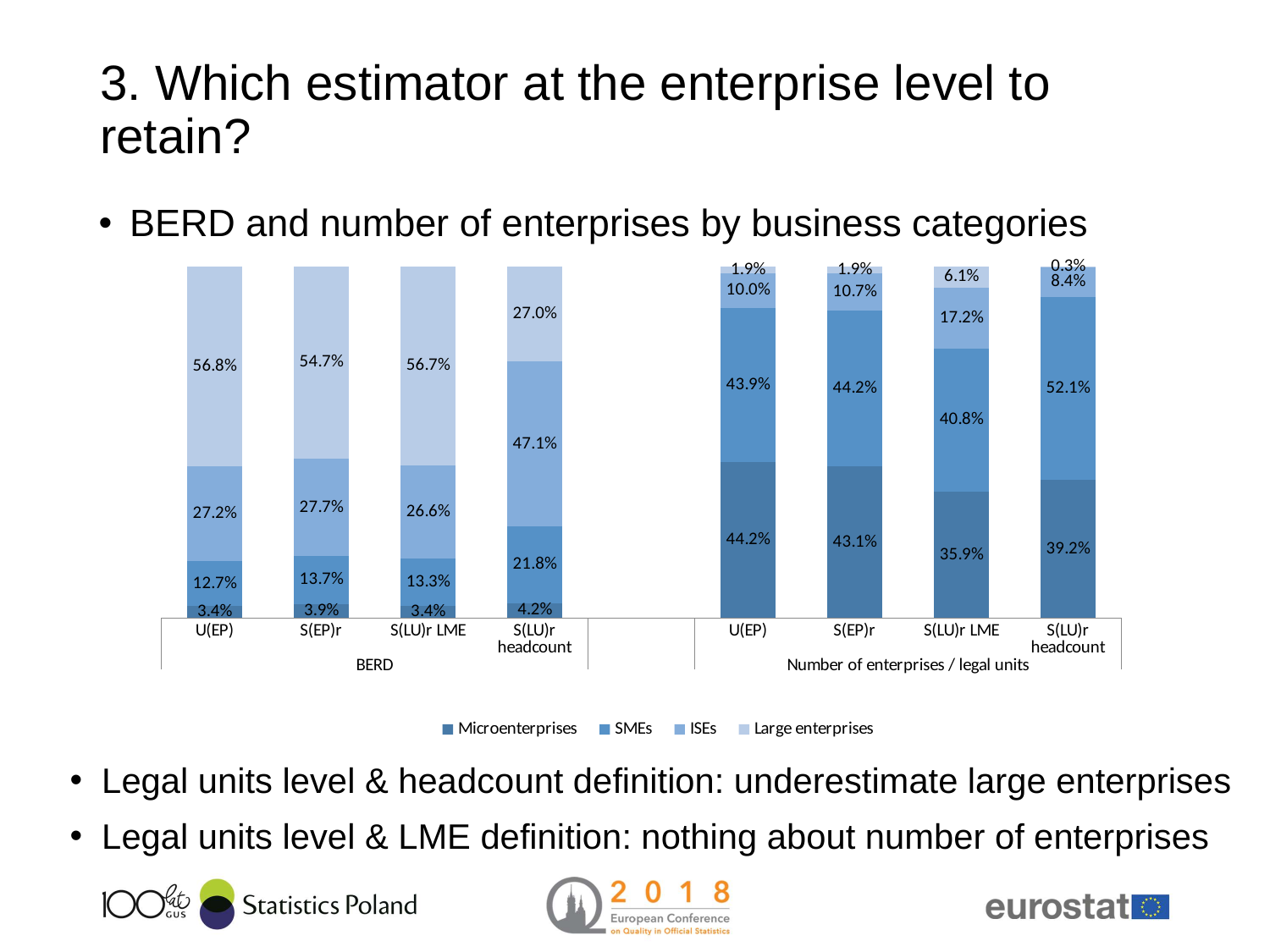
In the BERD group, which category has the highest Microenterprises share? S(LU)r headcount In the Number of enterprises / legal units group, which is larger: the SMEs share for S(LU)r headcount or for S(LU)r LME? S(LU)r headcount What is the Microenterprises share for S(LU)r headcount in the Number of enterprises / legal units group? 39.2% What kind of chart is shown on the slide? Stacked bar chart How many categories are shown on the x axis in total across both groups? 8 In the BERD group, what is the difference between the Large enterprises share for S(LU)r LME and for S(LU)r headcount? 29.7% In the Number of enterprises / legal units group, which category has the lowest Large enterprises share? S(LU)r headcount Which legend entry is listed first? Microenterprises What is the Large enterprises share for U(EP) in the BERD group? 56.8% How many series does the legend list? 4 What is the ISEs share for S(LU)r headcount in the BERD group? 47.1% What is the Large enterprises share for S(LU)r LME in the Number of enterprises / legal units group? 6.1%